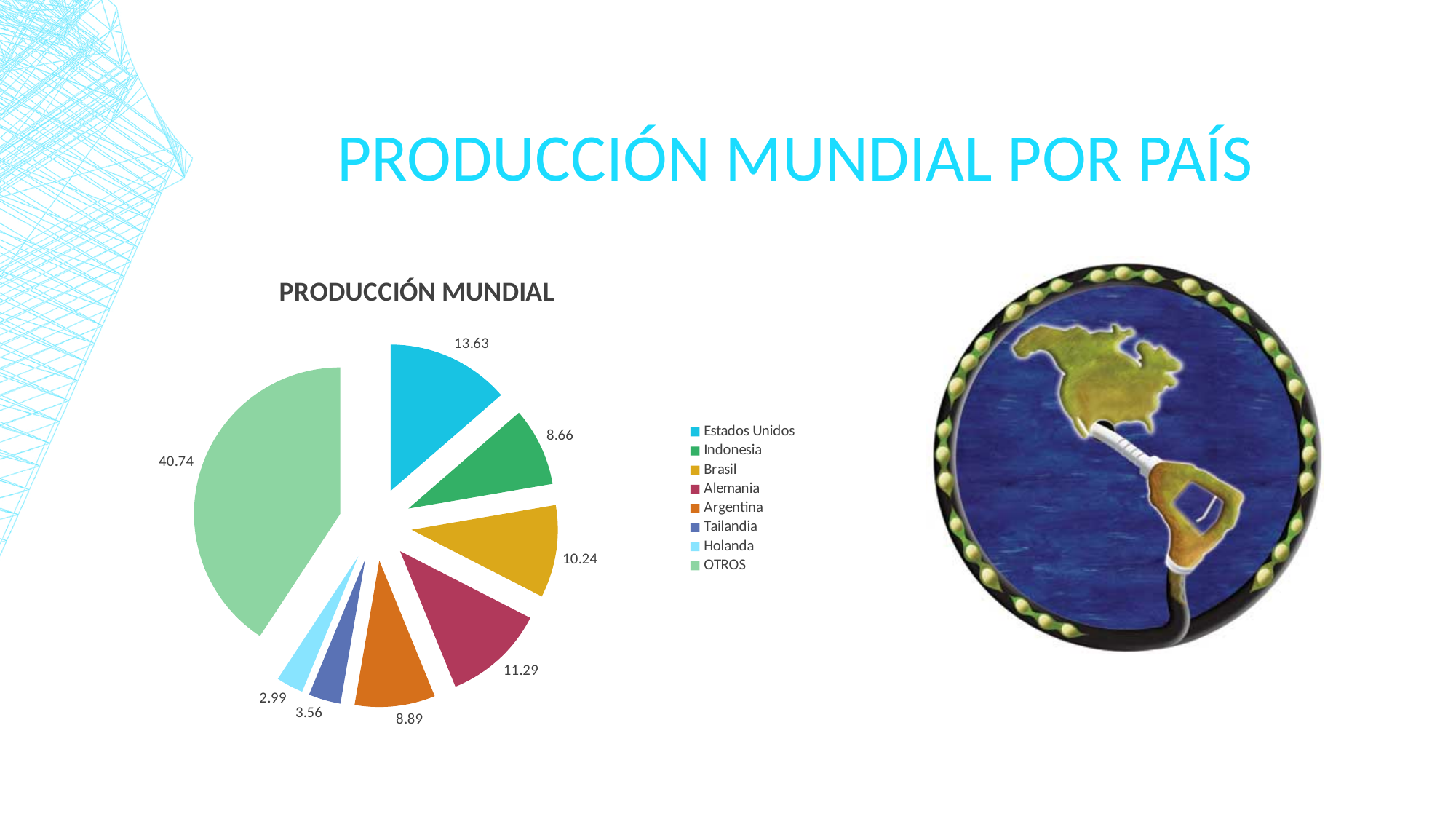
How many slices does the pie chart have? 8 What is the title of the chart? PRODUCCIÓN MUNDIAL How many series does the legend list? 8 What type of chart is shown on the slide? Pie chart What colour is the slice for Brasil? Yellow Which is larger, the value for Argentina or the value for Tailandia? Argentina What is the difference between the values for Brasil and Indonesia? 1.58 What is the value for Alemania? 11.29 Which category has the smallest slice? Holanda What is the value for Estados Unidos? 13.63 What is the value for Holanda? 2.99 Which category has the largest slice? OTROS